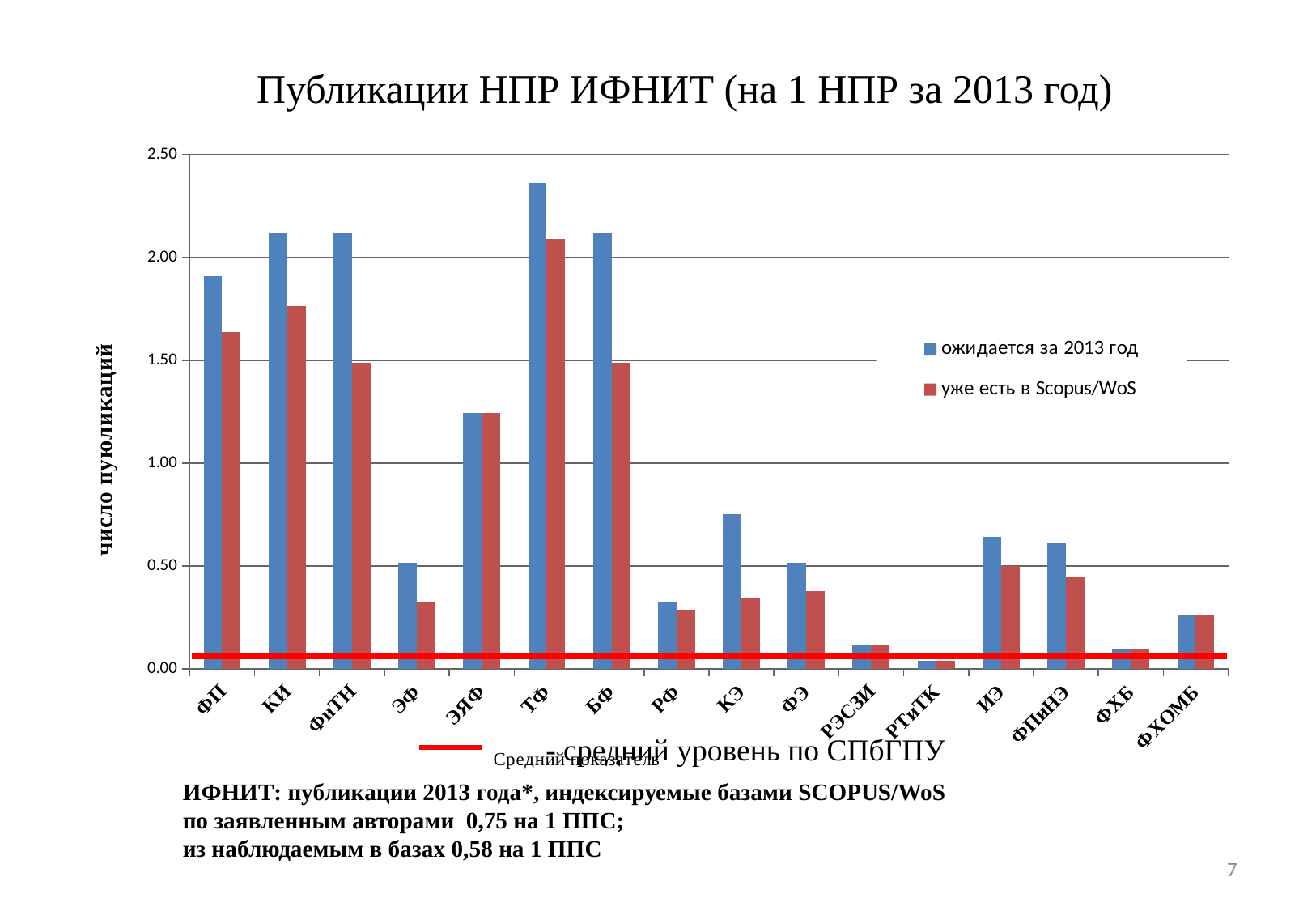
Is the value for КЭ in the series 'ожидается за 2013 год' greater or less than 0.50? greater Which category has the lowest value for the series 'ожидается за 2013 год'? РТиТК Is the value for КИ in the series 'уже есть в Scopus/WoS' greater or less than 1.50? greater Is the value for РФ in the series 'ожидается за 2013 год' greater or less than 0.50? less What is the title of the chart? Публикации НПР ИФНИТ (на 1 НПР за 2013 год) How many categories (departments) are shown along the x axis? 16 Which category has the highest value for the series 'уже есть в Scopus/WoS'? ТФ What kind of chart is shown on the slide? bar chart Which category has the highest value for the series 'ожидается за 2013 год'? ТФ For ИЭ, which series has the larger value: 'ожидается за 2013 год' or 'уже есть в Scopus/WoS'? ожидается за 2013 год How many series does the legend list? 2